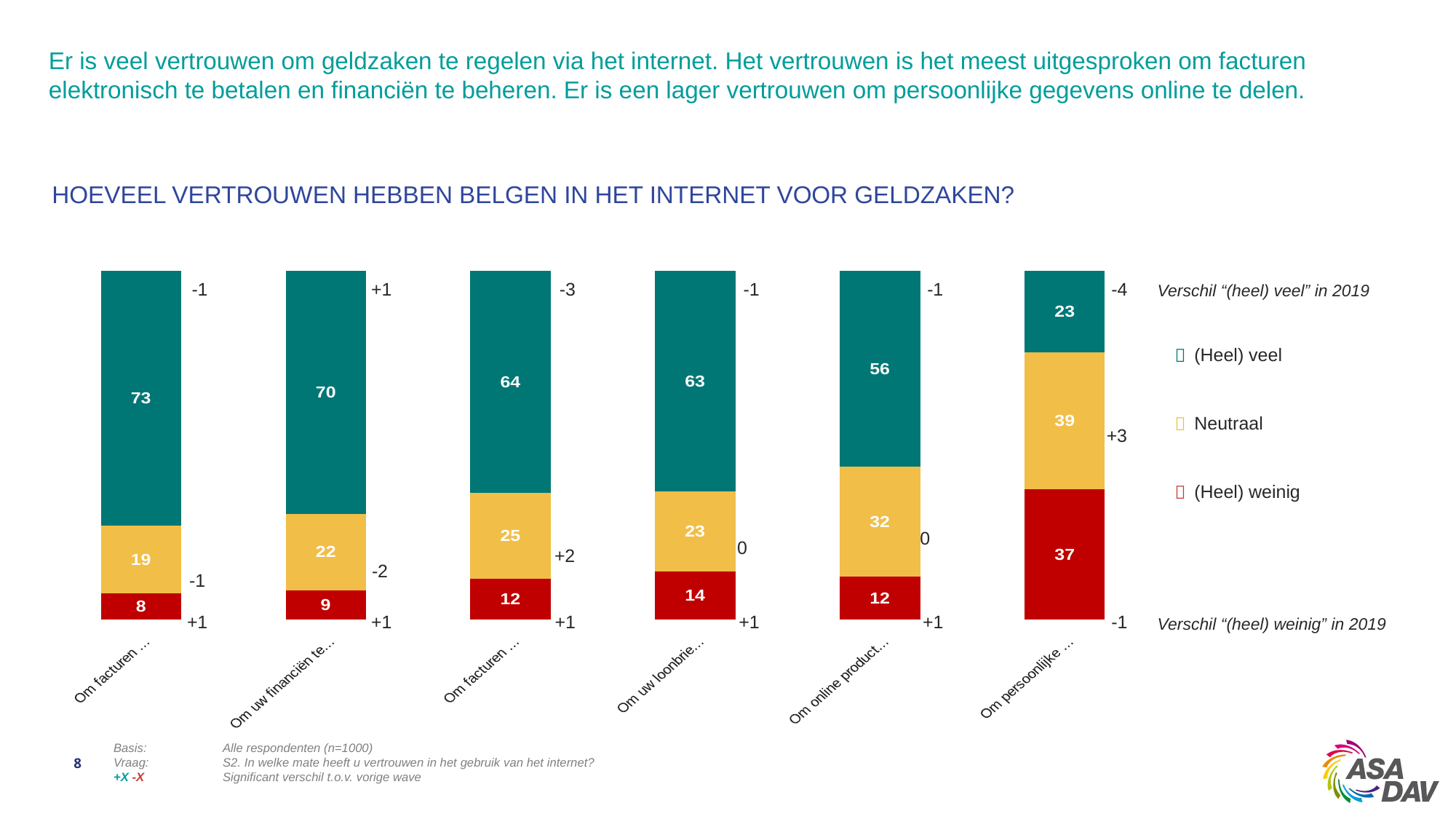
What is the difference in the "(Heel) weinig" value between "Om persoonlijke ..." and "Om uw loonbrie..."? 23 How many series does the legend list? 3 Which bar has the lowest "(Heel) veel" value? Om persoonlijke ... (23) How many bars (categories) are plotted in the chart? 6 Which has the larger "Neutraal" value: "Om online product..." or "Om uw financiën te..."? Om online product... Which colour represents "(Heel) weinig" in the legend? Red What is the "Neutraal" value for the bar labelled "Om persoonlijke ..."? 39 What is the "(Heel) veel" value for the bar labelled "Om uw loonbrie..."? 63 What kind of chart is shown on the slide? Stacked bar chart Which bar has the highest "(Heel) veel" value? The first (leftmost) bar, "Om facturen ..." (73) What is the "(Heel) weinig" value for the bar labelled "Om online product..."? 12 What is the total of the first (leftmost) stacked bar? 100